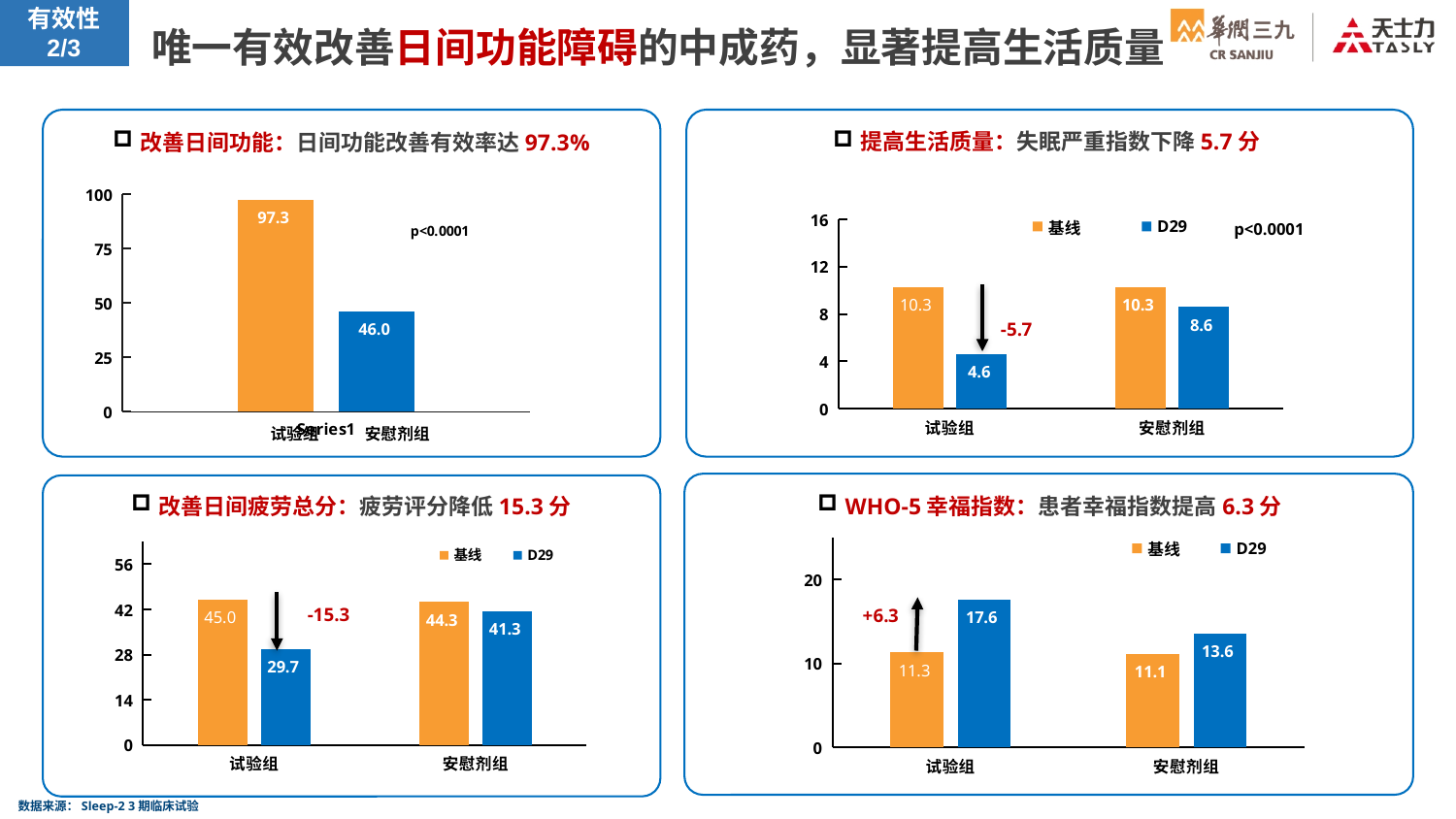
In the top-left chart (改善日间功能), what is the value for 试验组? 97.3 In the top-left chart (改善日间功能), what is the difference between the 试验组 and 安慰剂组 values? 51.3 In the bottom-left chart (改善日间疲劳总分), what is the D29 value for 试验组? 29.7 In the top-left chart (改善日间功能), what is the value for 安慰剂组? 46.0 In the top-right chart (提高生活质量), what is the D29 value for 试验组? 4.6 In the top-right chart (提高生活质量), what is the 基线 value for 安慰剂组? 10.3 In the top-right chart (提高生活质量), how many series does the legend list? 2 In the bottom-right chart (WHO-5 幸福指数), is the 基线 value for 安慰剂组 greater or less than 10? greater In the bottom-right chart (WHO-5 幸福指数), which group has the higher D29 value, 试验组 or 安慰剂组? 试验组 What kind of chart is the top-left chart (改善日间功能)? bar chart In the bottom-left chart (改善日间疲劳总分), what is the difference between the 基线 and D29 values for 安慰剂组? 3.0 In the bottom-right chart (WHO-5 幸福指数), what is the D29 value for 试验组? 17.6